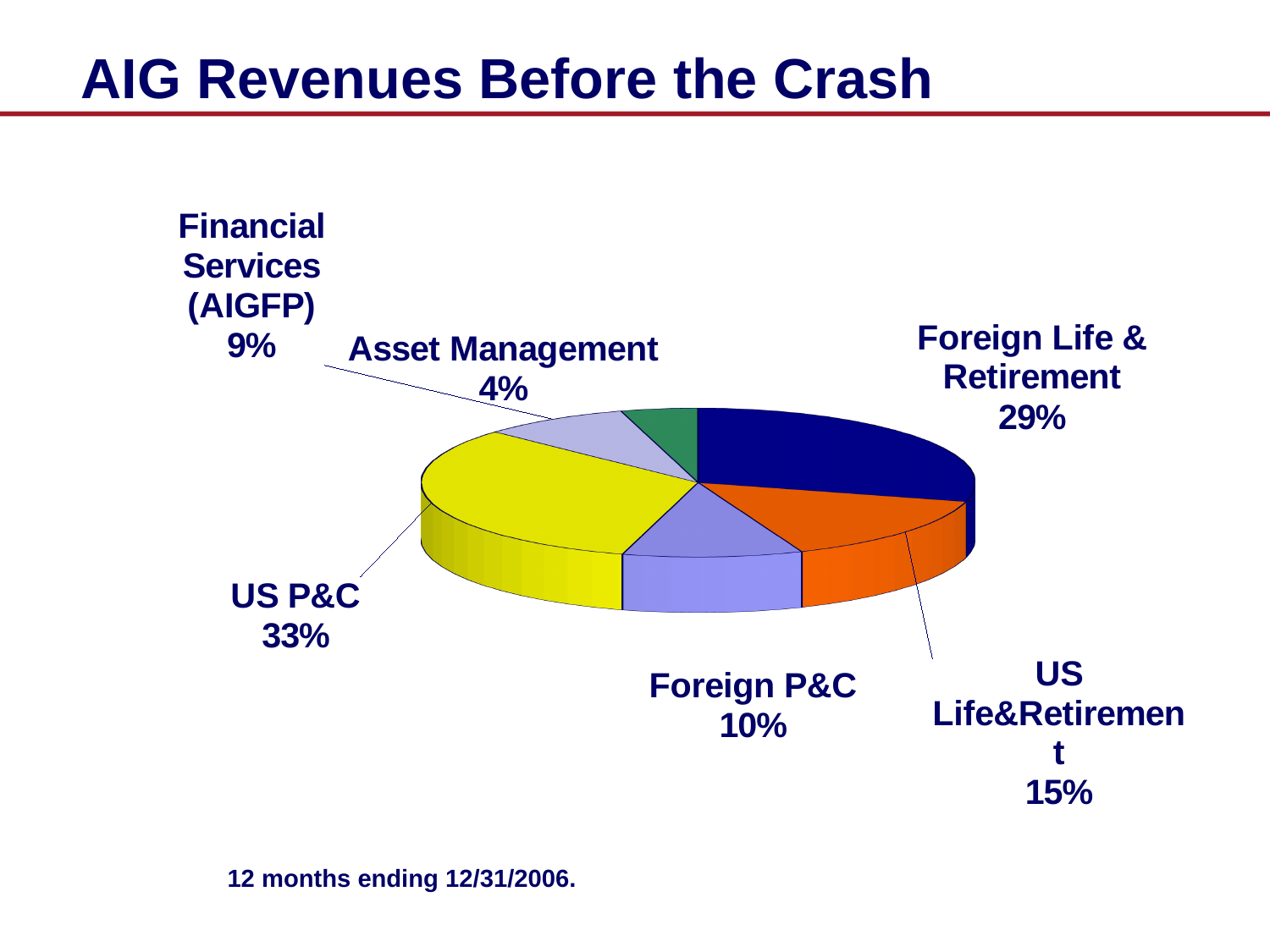
How many segments are shown in the pie chart? 6 What kind of chart is shown on the slide? Pie chart Which is larger, US Life&Retirement or Foreign P&C? US Life&Retirement What share of AIG revenues comes from US P&C? 33% What is the title of the chart? AIG Revenues Before the Crash What percentage is shown for Foreign P&C? 10% What percentage is shown for Financial Services (AIGFP)? 9% What share of AIG revenues comes from Foreign Life & Retirement? 29% What percentage is shown for Asset Management? 4% Which segment has the smallest share of AIG revenues? Asset Management Which segment has the largest share of AIG revenues? US P&C What is the difference in percentage points between US P&C and Foreign Life & Retirement? 4